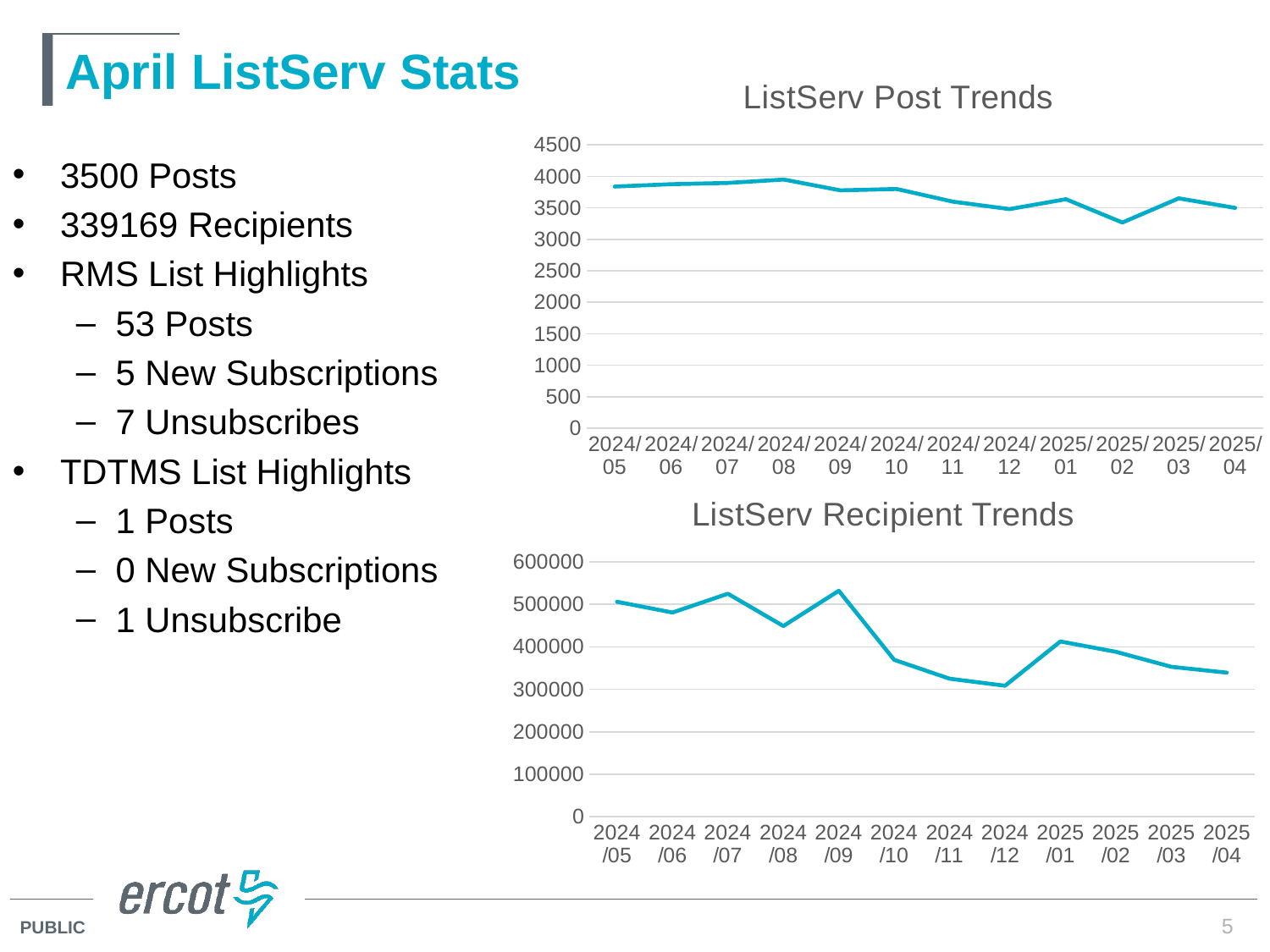
In the ListServ Post Trends chart, which month has the lowest number of posts? 2025/02 How many data points are plotted on the ListServ Recipient Trends chart? 12 What kind of chart is the ListServ Recipient Trends chart? Line chart In the ListServ Post Trends chart, is the value for 2025/02 greater or less than 3500? less In the ListServ Recipient Trends chart, which is larger, the value for 2024/09 or the value for 2024/12? 2024/09 In the ListServ Recipient Trends chart, is the value for 2024/12 greater or less than 400000? less In the ListServ Recipient Trends chart, is the value for 2024/09 greater or less than 500000? greater How many months are plotted on the ListServ Post Trends chart? 12 What kind of chart is the ListServ Post Trends chart? Line chart Overall, do the values in the ListServ Recipient Trends chart rise or fall from 2024/05 to 2025/04? Fall In the ListServ Post Trends chart, which month has the highest number of posts? 2024/08